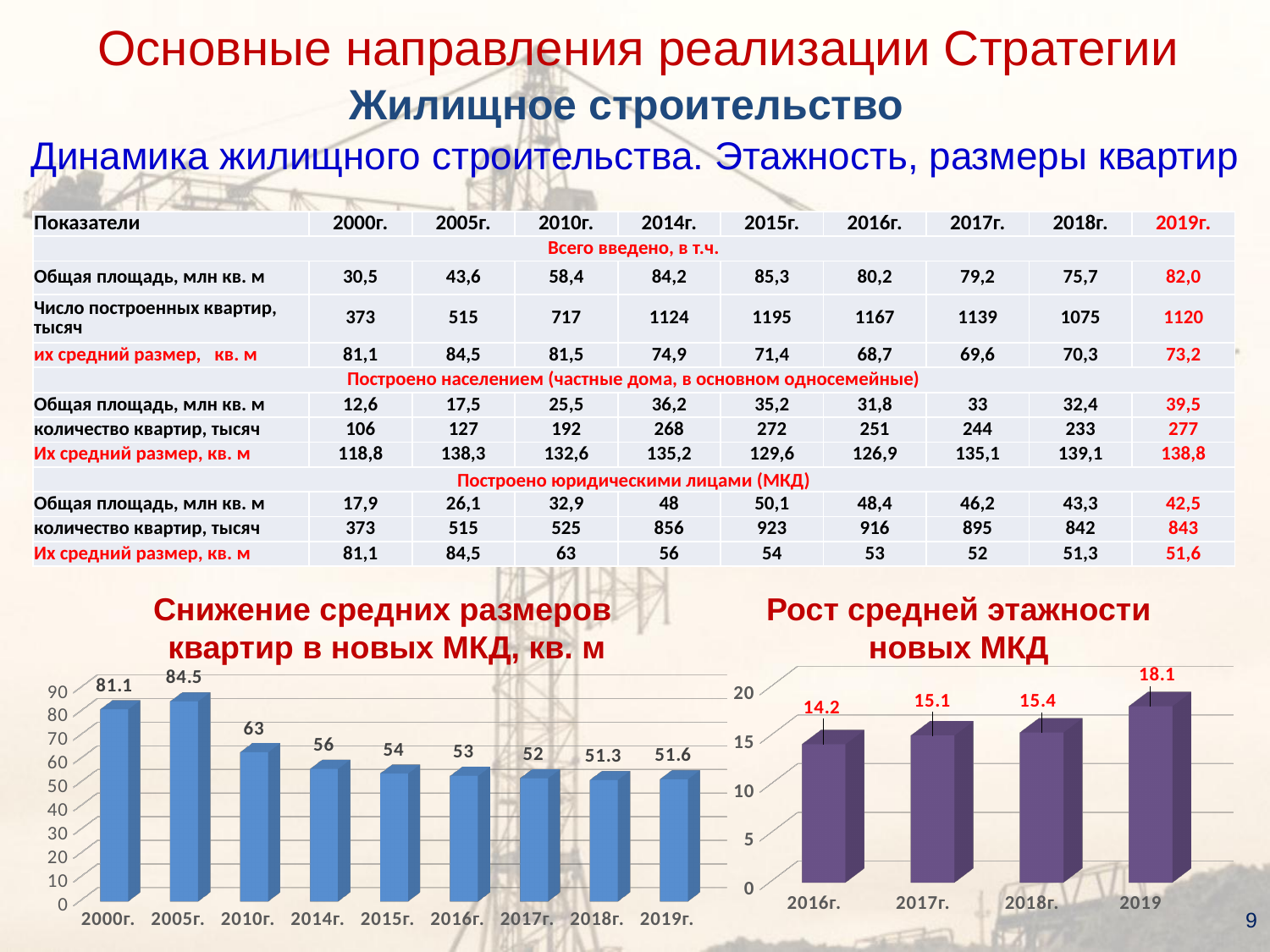
In the chart 'Рост средней этажности новых МКД', which year has the highest value? 2019 In the chart 'Снижение средних размеров квартир в новых МКД, кв. м', what is the value for 2018г.? 51.3 In the chart 'Снижение средних размеров квартир в новых МКД, кв. м', which year has the lowest value? 2018г. In the chart 'Снижение средних размеров квартир в новых МКД, кв. м', what is the difference between the values for 2005г. and 2010г.? 21.5 In the chart 'Снижение средних размеров квартир в новых МКД, кв. м', how many years are shown on the x axis? 9 What kind of chart is 'Рост средней этажности новых МКД'? bar chart In the chart 'Снижение средних размеров квартир в новых МКД, кв. м', which year has the highest value? 2005г. In the chart 'Снижение средних размеров квартир в новых МКД, кв. м', do the values generally rise or fall from 2005г. to 2018г.? fall In the chart 'Рост средней этажности новых МКД', is the value for 2016г. greater or less than 15? less In the chart 'Рост средней этажности новых МКД', what is the value for 2017г.? 15.1 In the chart 'Снижение средних размеров квартир в новых МКД, кв. м', what is the value for 2010г.? 63 In the chart 'Рост средней этажности новых МКД', what is the difference between the values for 2019 and 2016г.? 3.9